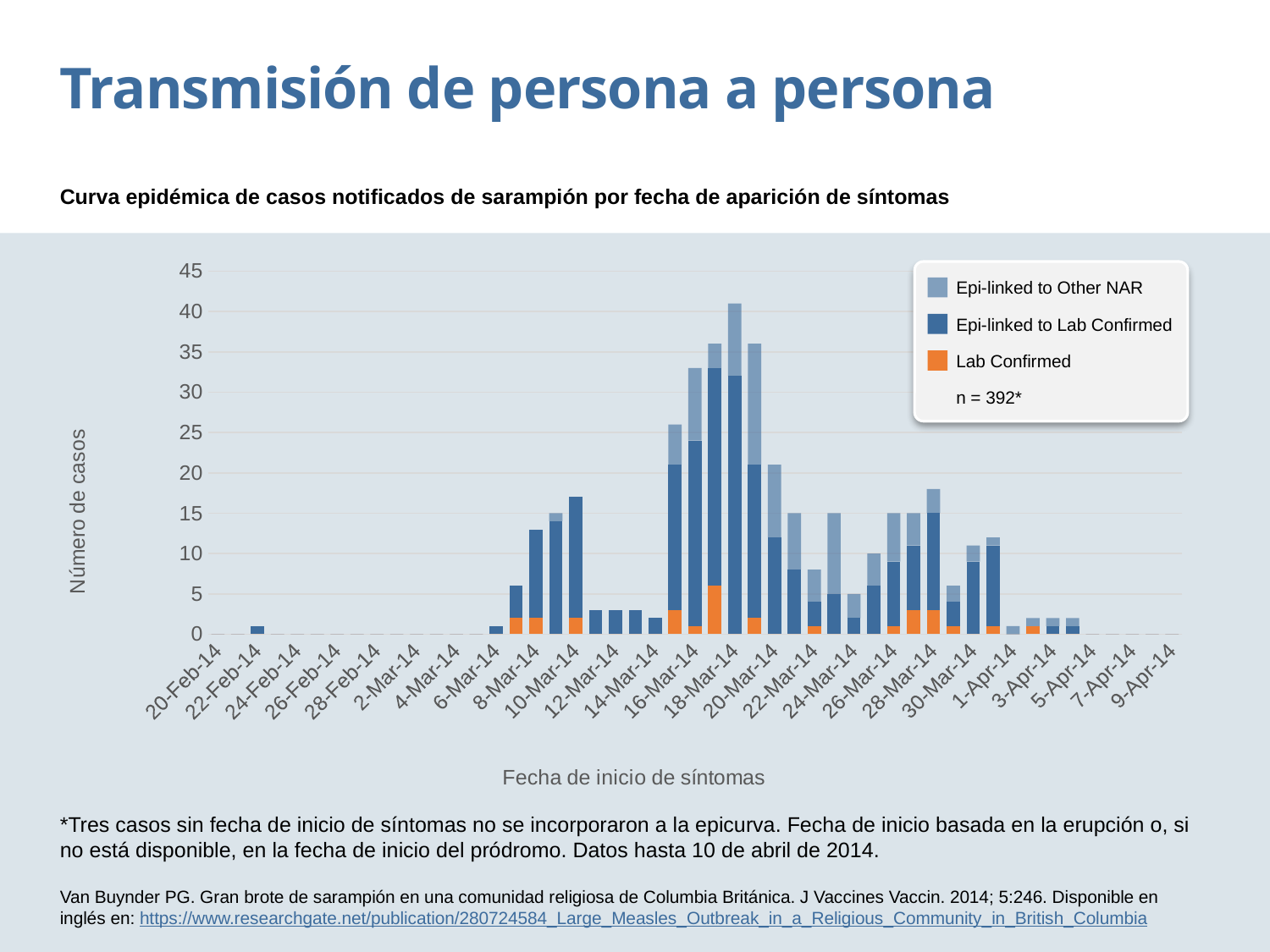
How many series does the legend list? 3 What value of n is given in the legend box? n = 392* Which series is shown in orange in the legend? Lab Confirmed Is the total value for 18-Mar-14 greater or less than 35? greater Is the total value for 12-Mar-14 greater or less than 5? less Do the bar totals rise or fall from 18-Mar-14 to 22-Mar-14? fall Is the total value for 10-Mar-14 greater or less than 15? greater On which date does the tallest bar occur? 18-Mar-14 What kind of chart is shown on the slide? Stacked bar chart Which date has the taller bar, 8-Mar-14 or 12-Mar-14? 8-Mar-14 Which date has the taller bar, 16-Mar-14 or 18-Mar-14? 18-Mar-14